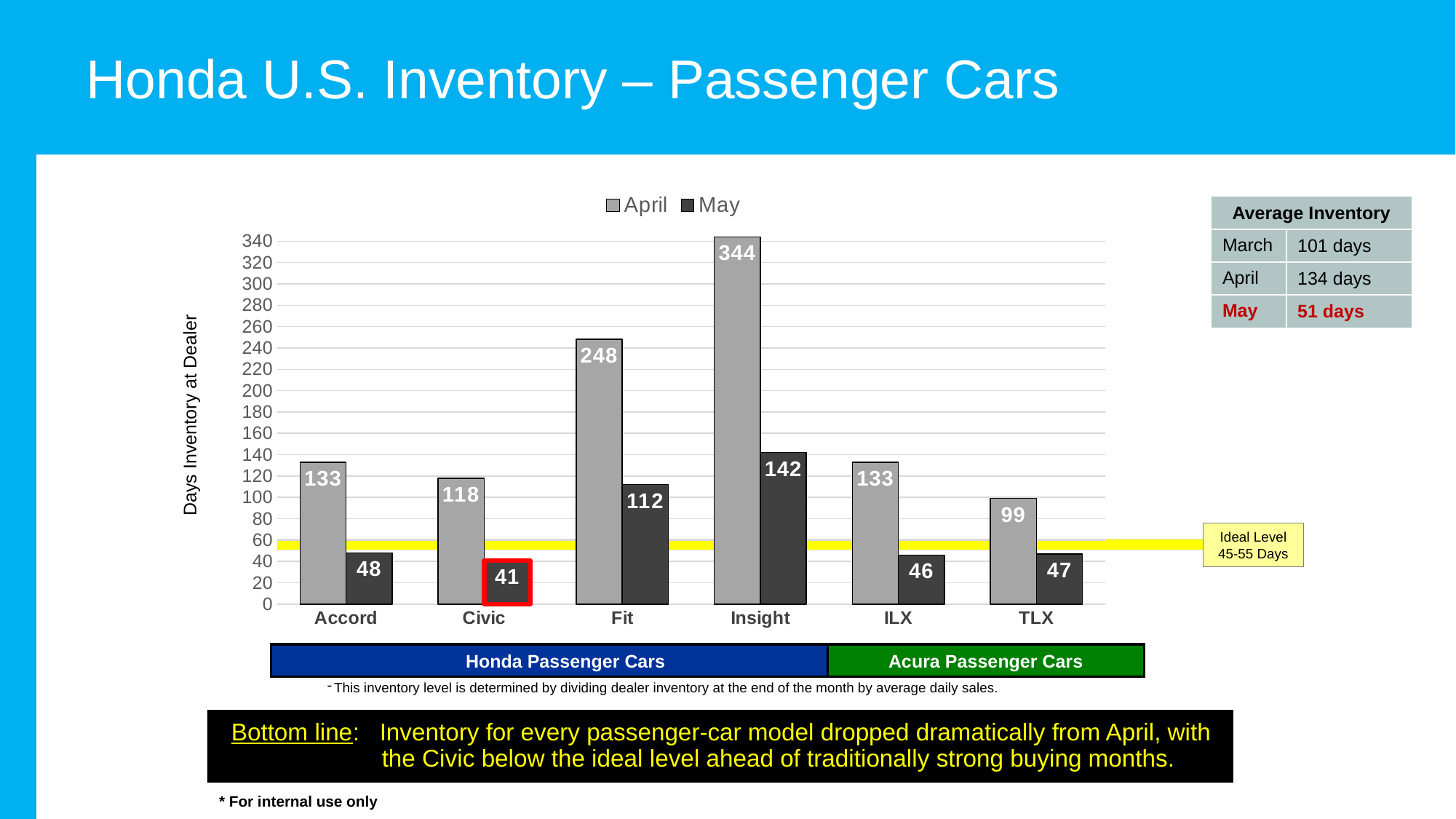
What is the April days inventory value for the Insight? 344 Which model has the highest April days inventory? Insight Which is larger, the May value for the Fit or the May value for the Insight? Insight What is the difference between the April and May days inventory for the Insight? 202 How many series does the chart legend list? 2 What is the May days inventory value for the Fit? 112 Which model's May bar is outlined in red on the chart? Civic What is the label of the y axis of the chart? Days Inventory at Dealer What is the May days inventory value for the Civic? 41 What kind of chart is shown on the slide? Bar chart How many car models are shown on the x axis of the chart? 6 Which model has the lowest May days inventory? Civic